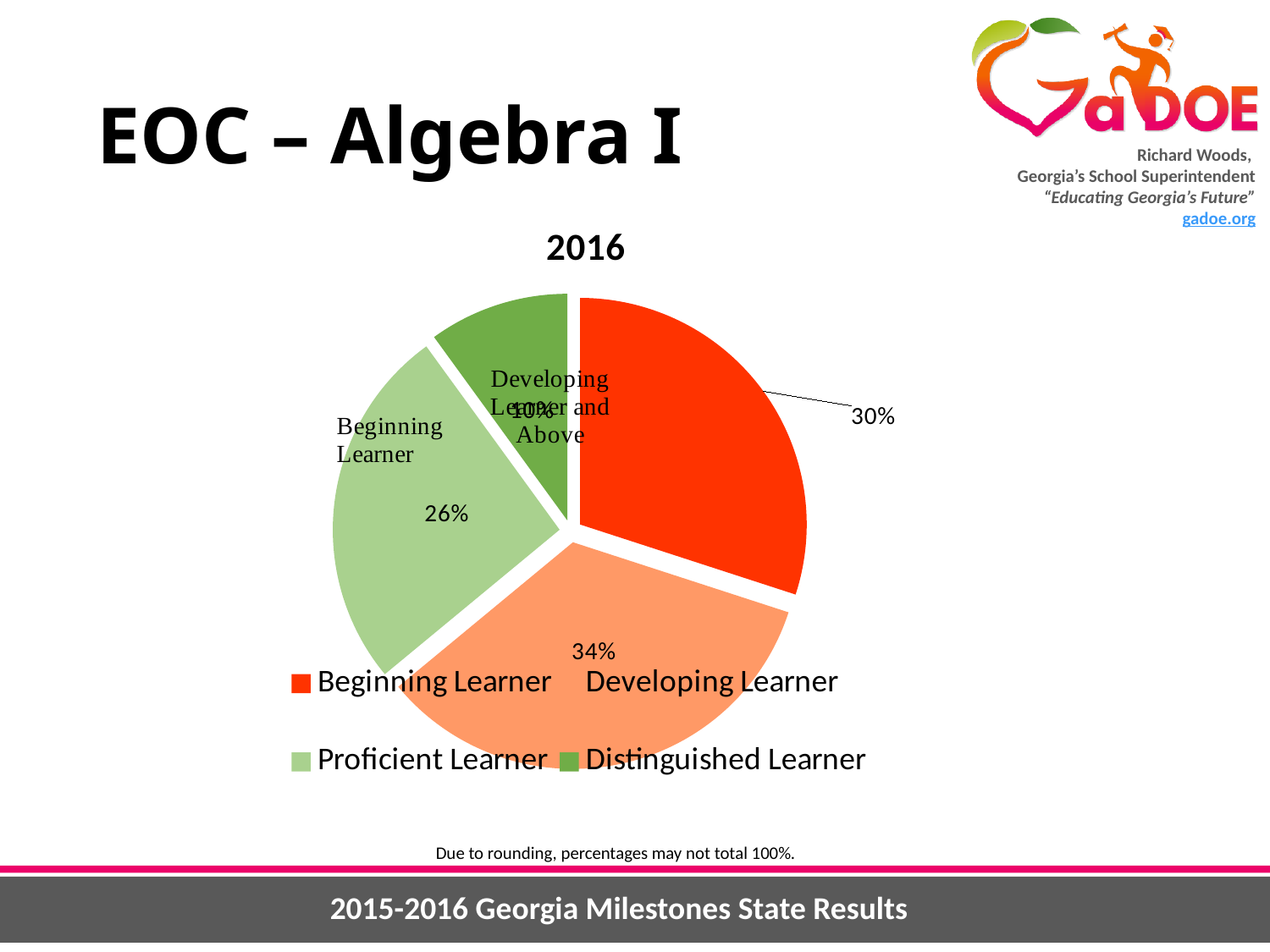
Which category has the smallest slice of the pie? Distinguished Learner What kind of chart is shown on the slide? pie chart How many categories does the legend list? 4 What percentage of the pie is Proficient Learner? 26% How many slices does the pie chart have? 4 What percentage of the pie is Beginning Learner? 30% Which is larger, the Beginning Learner slice or the Proficient Learner slice? Beginning Learner Which category has the largest slice of the pie? Developing Learner What is the title of the chart? 2016 Is the Distinguished Learner slice greater or less than 20% of the pie? less What is the difference in percentage points between Developing Learner and Proficient Learner? 8 What percentage of the pie is Developing Learner? 34%